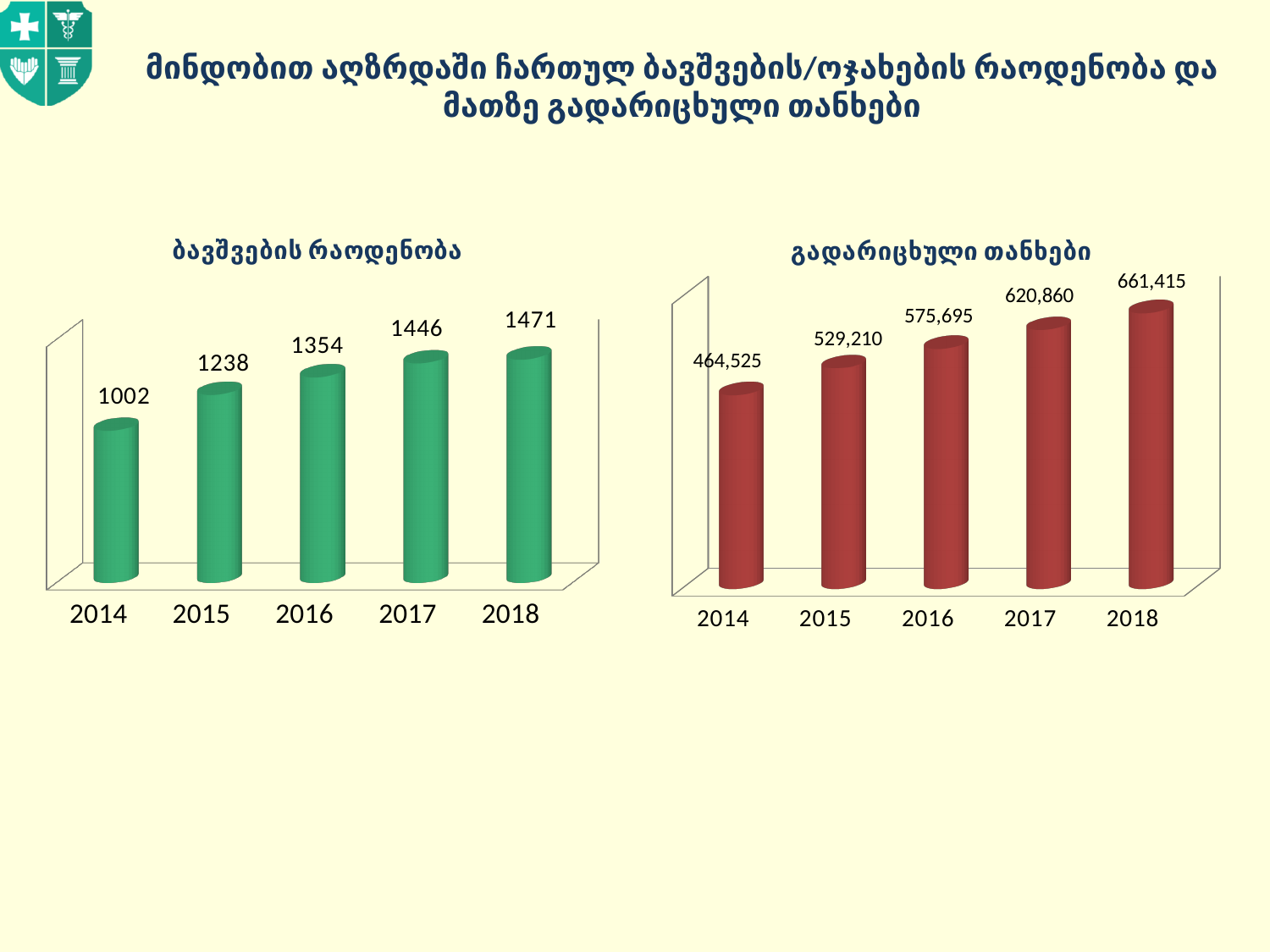
How many years are shown on the x axis of the right chart (გადარიცხული თანხები)? 5 In the right chart (გადარიცხული თანხები), what is the value for 2018? 661,415 In the right chart (გადარიცხული თანხები), what is the value for 2016? 575,695 What kind of chart is the left chart (ბავშვების რაოდენობა)? bar chart In the left chart (ბავშვების რაოდენობა), what is the difference between the values for 2018 and 2014? 469 In the left chart (ბავშვების რაოდენობა), which year has the highest value? 2018 In the left chart (ბავშვების რაოდენობა), what is the value for 2014? 1002 In the right chart (გადარიცხული თანხები), which is larger, the value for 2017 or the value for 2016? 2017 In the left chart (ბავშვების რაოდენობა), what is the value for 2017? 1446 In the right chart (გადარიცხული თანხები), which year has the lowest value? 2014 In the left chart (ბავშვების რაოდენობა), do the values rise or fall from 2014 to 2018? rise In the right chart (გადარიცხული თანხები), what is the difference between the values for 2015 and 2014? 64,685